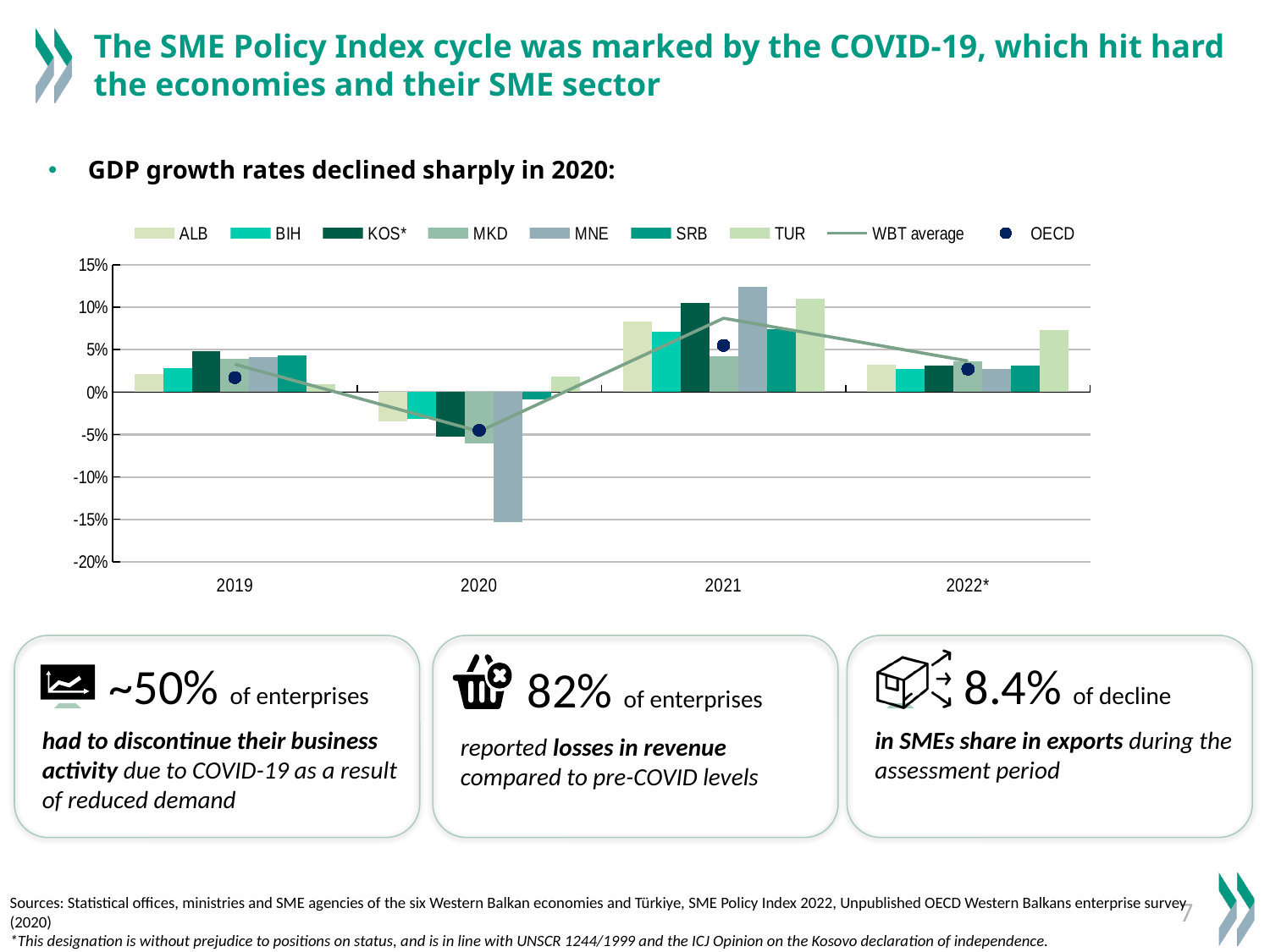
Which series is plotted as a line rather than bars in the GDP growth chart? WBT average Is the GDP growth rate for MNE in 2020 greater or less than -10%? less Which series is shown as dots in the GDP growth chart? OECD What kind of chart is shown on the slide? combination bar and line chart Which economy has the lowest GDP growth rate in 2020? MNE Does the WBT average line rise or fall from 2019 to 2020? fall Which economy has the highest GDP growth rate in 2021? MNE Which economy has the highest GDP growth rate in 2022*? TUR How many years are shown along the x axis of the GDP growth chart? 4 Is the GDP growth rate for ALB in 2021 greater or less than 5%? greater How many series does the legend of the GDP growth chart list? 9 Is the GDP growth rate for MNE in 2021 greater or less than 10%? greater